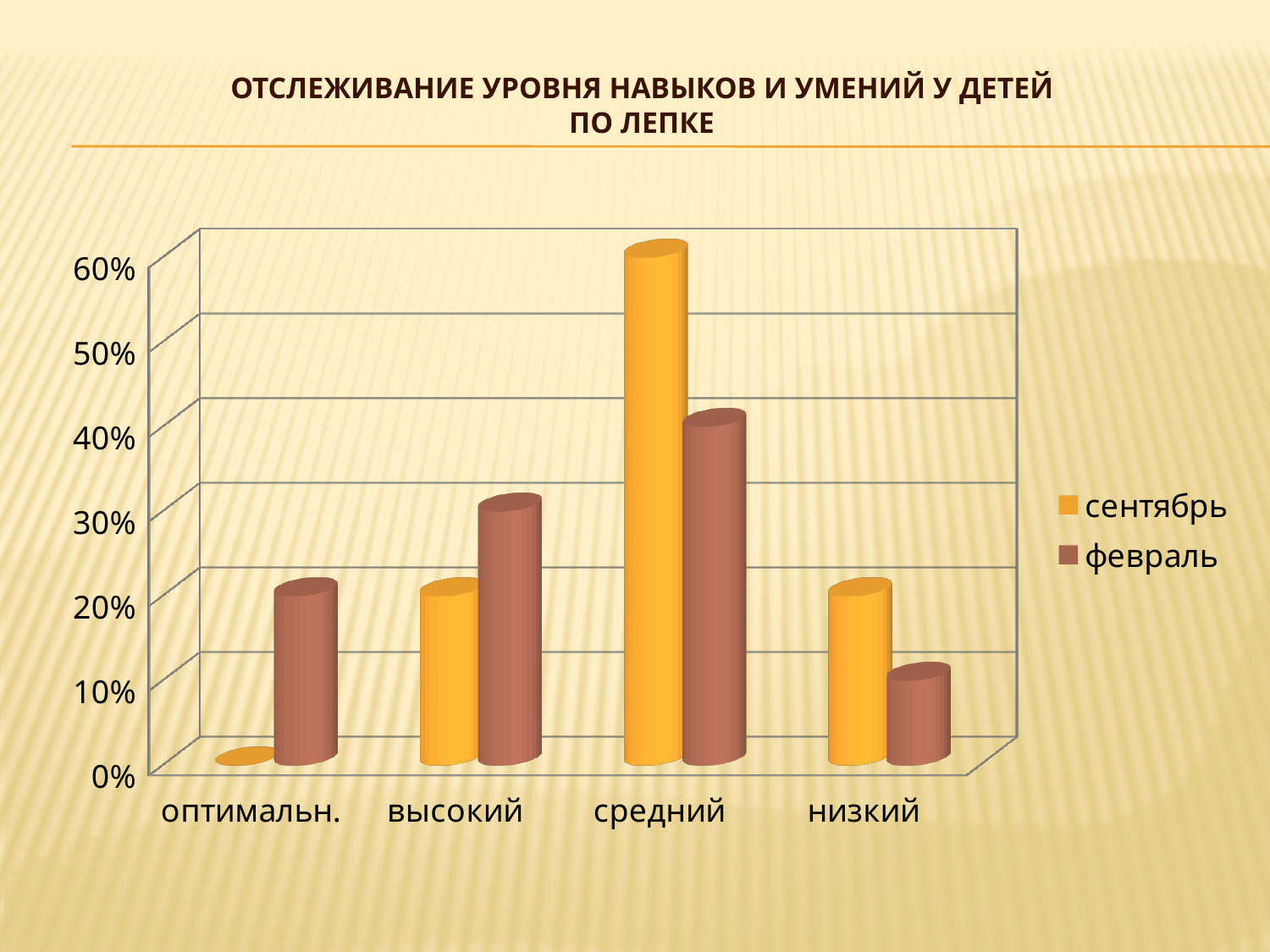
Which category has the lowest value for февраль? низкий How many categories are shown on the x axis? 4 For the category высокий, which series has the larger value, сентябрь or февраль? февраль Which category has the highest value for февраль? средний How many series does the legend list? 2 What are the two series named in the legend? сентябрь and февраль Which category has the highest value for сентябрь? средний Which category has the lowest value for сентябрь? оптимальн. What kind of chart is shown on the slide? bar chart Is the value for низкий in февраль greater or less than 20%? less Is the value for средний in сентябрь greater or less than 50%? greater For the category низкий, which series has the larger value, сентябрь or февраль? сентябрь